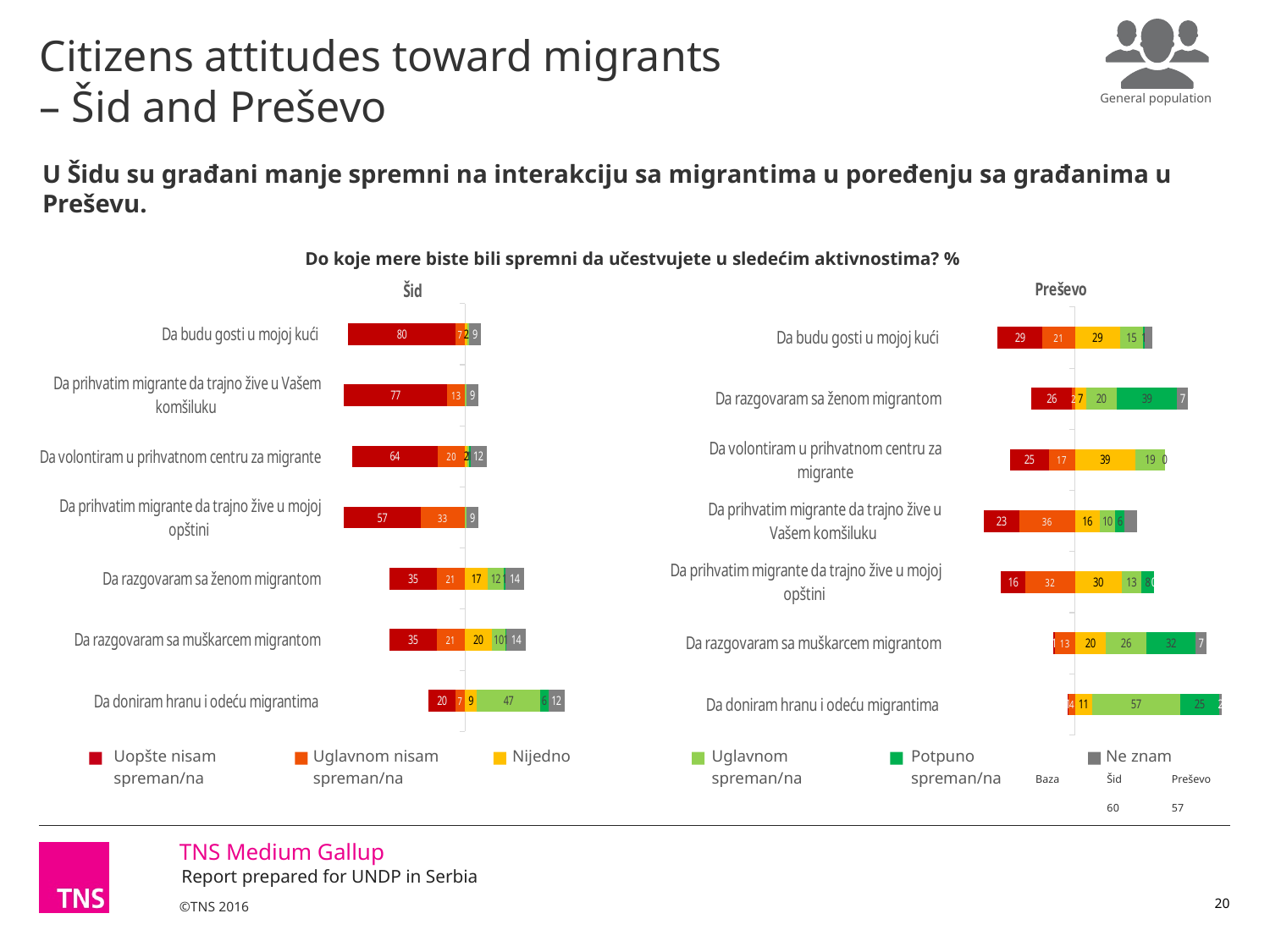
How many activities are listed in the Šid chart? 7 In the Preševo chart, what is the value of 'Potpuno spreman/na' for 'Da razgovaram sa ženom migrantom'? 39 In the Šid chart, what is the difference between the 'Uopšte nisam spreman/na' values for 'Da budu gosti u mojoj kući' and 'Da prihvatim migrante da trajno žive u mojoj opštini'? 23 In the Šid chart, which activity has the highest 'Uopšte nisam spreman/na' value? Da budu gosti u mojoj kući In the Šid chart, which activity has the lowest 'Uopšte nisam spreman/na' value? Da doniram hranu i odeću migrantima What type of chart is used for Šid and Preševo? Stacked bar chart Which is larger: the 'Uopšte nisam spreman/na' value for 'Da budu gosti u mojoj kući' in the Šid chart or in the Preševo chart? Šid What is the base (Baza) size shown for Preševo? 57 In the Preševo chart, what is the value of 'Uglavnom spreman/na' for 'Da doniram hranu i odeću migrantima'? 57 How many series does the legend list? 6 In the Šid chart, what is the value of 'Uglavnom spreman/na' for 'Da doniram hranu i odeću migrantima'? 47 In the Šid chart, what is the value of 'Uopšte nisam spreman/na' for 'Da budu gosti u mojoj kući'? 80